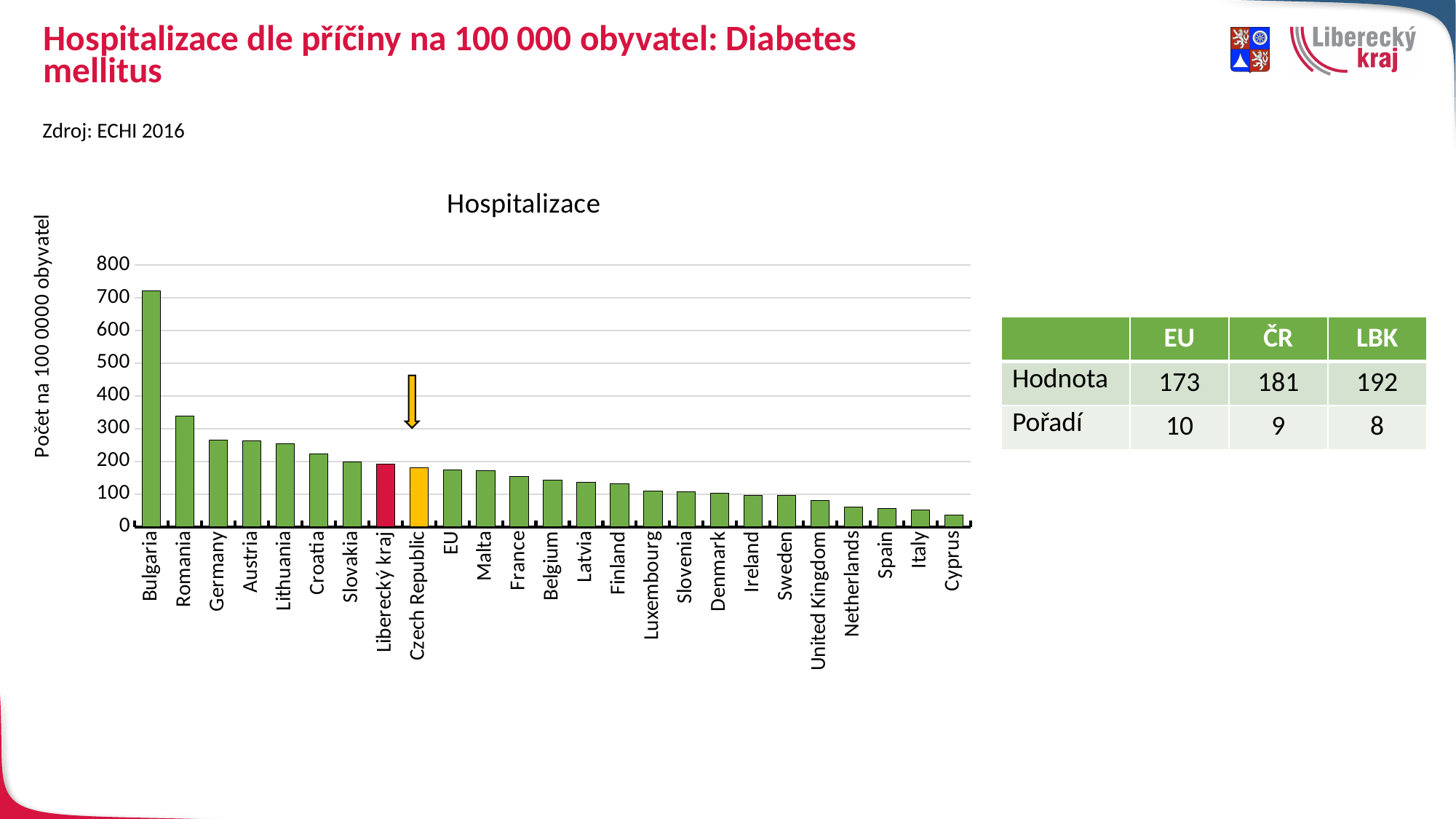
What is the difference between the values for Liberecký kraj and the EU? 19 Which is larger, the value for Romania or the value for Germany? Romania Is the value for Bulgaria greater or less than 600? greater How many bars (categories) are plotted in the chart? 25 Which country has the highest hospitalization rate in the chart? Bulgaria Do the values rise or fall moving from left to right along the x axis? fall What type of chart is shown under the title "Hospitalizace"? bar chart Which country has the lowest hospitalization rate in the chart? Cyprus Is the value for Cyprus greater or less than 100? less What is the hospitalization value for the EU? 173 What is the hospitalization value for Liberecký kraj (LBK)? 192 What is the hospitalization value for the Czech Republic (ČR)? 181